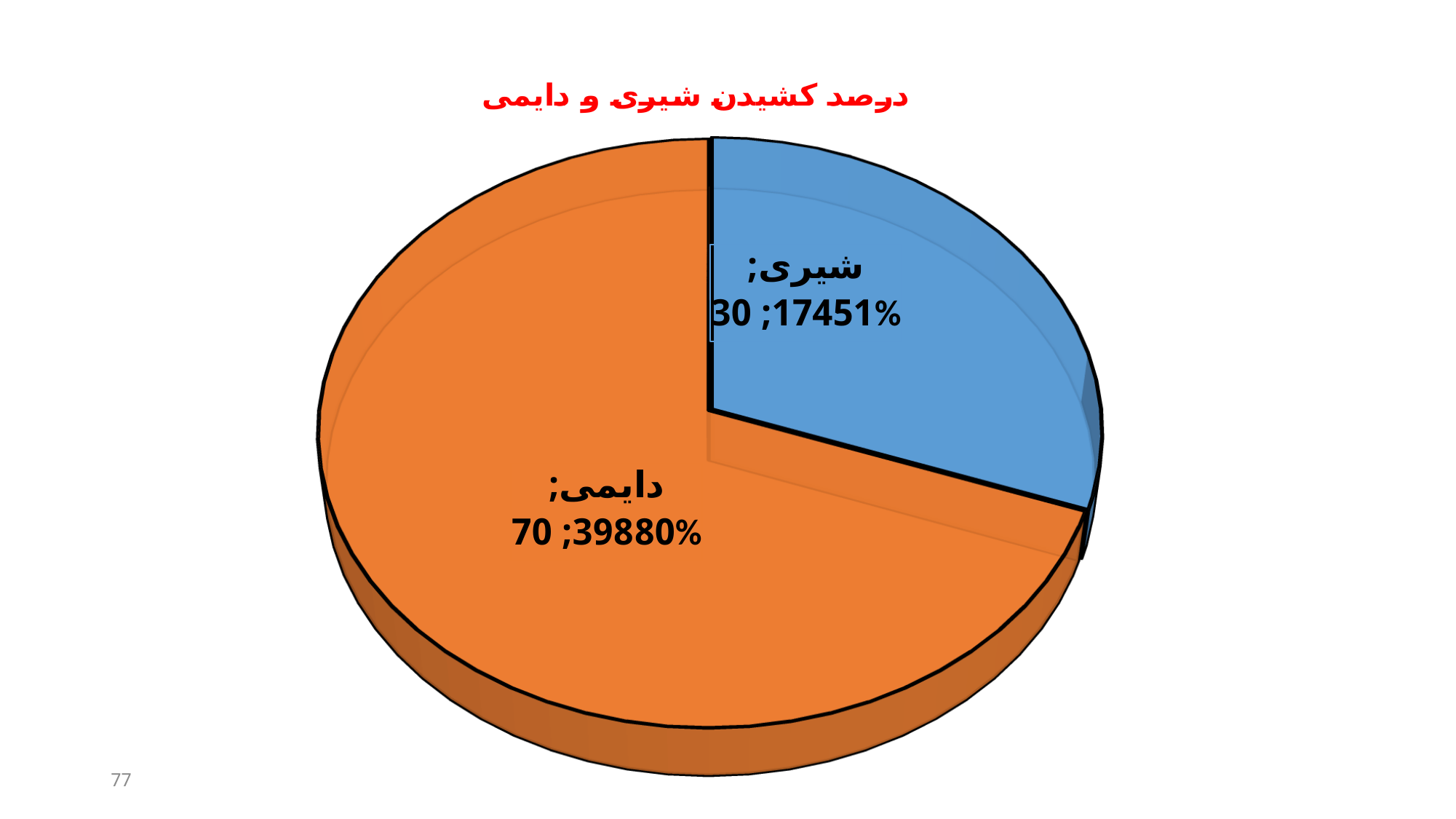
Which slice is the largest? دایمی What is the title of the chart? درصد کشیدن شیری و دایمی What percentage share does the شیری slice have? 30% What colour is the دایمی slice? orange What is the value shown for the دایمی slice? 39880 What is the difference between the values for دایمی and شیری? 22429 What percentage share does the دایمی slice have? 70% How many slices does the pie chart have? 2 Which slice is the smallest? شیری What kind of chart is shown on the slide? pie chart What is the value shown for the شیری slice? 17451 Which is larger, the value for شیری or the value for دایمی? دایمی